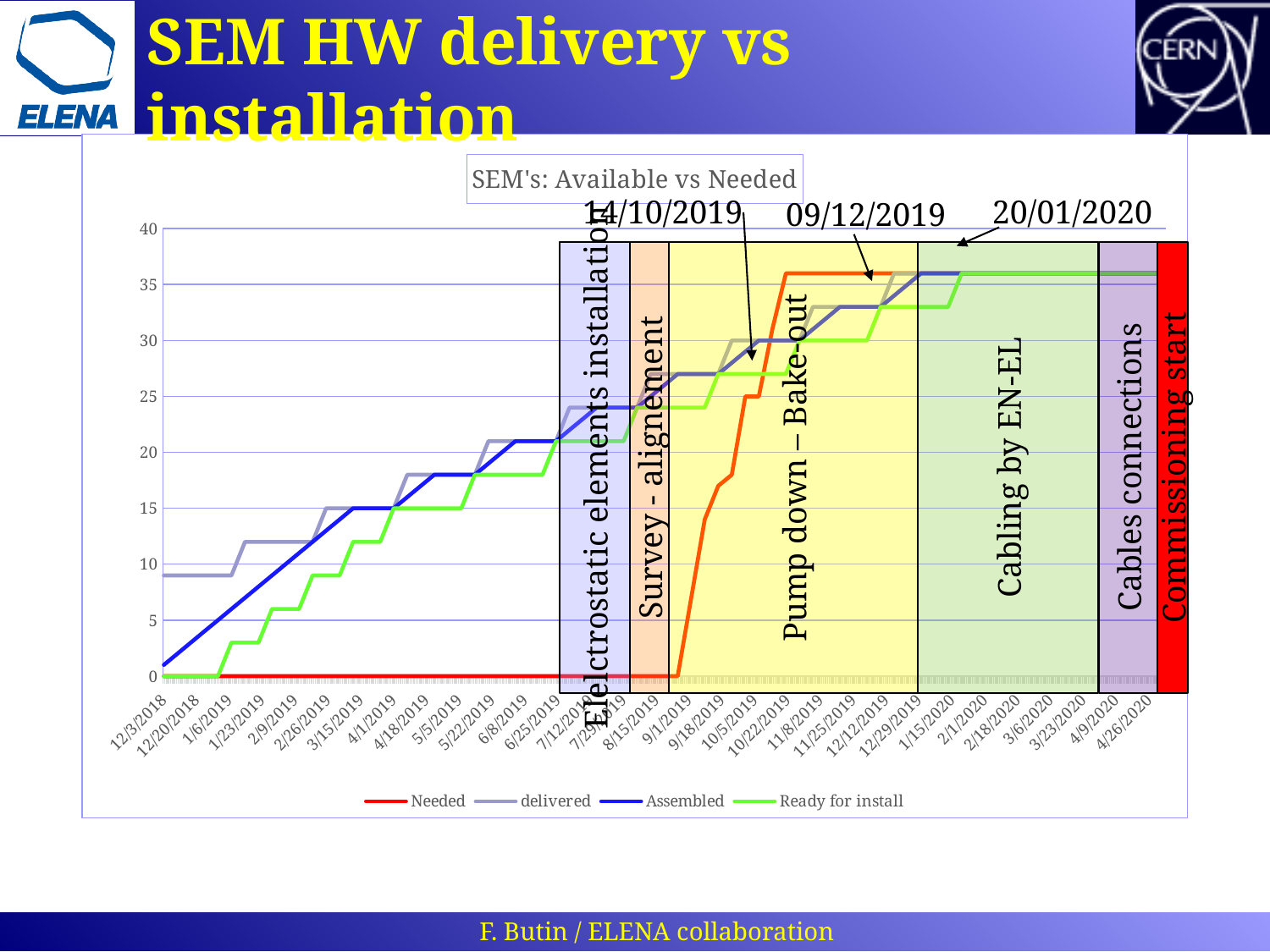
How many series does the chart legend list? 4 Is the value of the Ready for install series at 6/8/2019 greater or less than 20? less At 9/18/2019, which is larger: the Needed value or the Assembled value? Assembled Which series has the lowest value at 8/15/2019? Needed What is the value of the Needed series at 12/3/2018? 0 Is the value of the Assembled series at 4/26/2020 greater or less than 30? greater Which series is drawn in red in the chart? Needed What kind of chart is shown on the slide? line chart Is the value of the Needed series at 8/15/2019 greater or less than 5? less Which series has the highest value at 12/3/2018? delivered Does the Assembled series generally rise or fall from 12/3/2018 to 4/26/2020? rise What is the title of the chart? SEM's: Available vs Needed